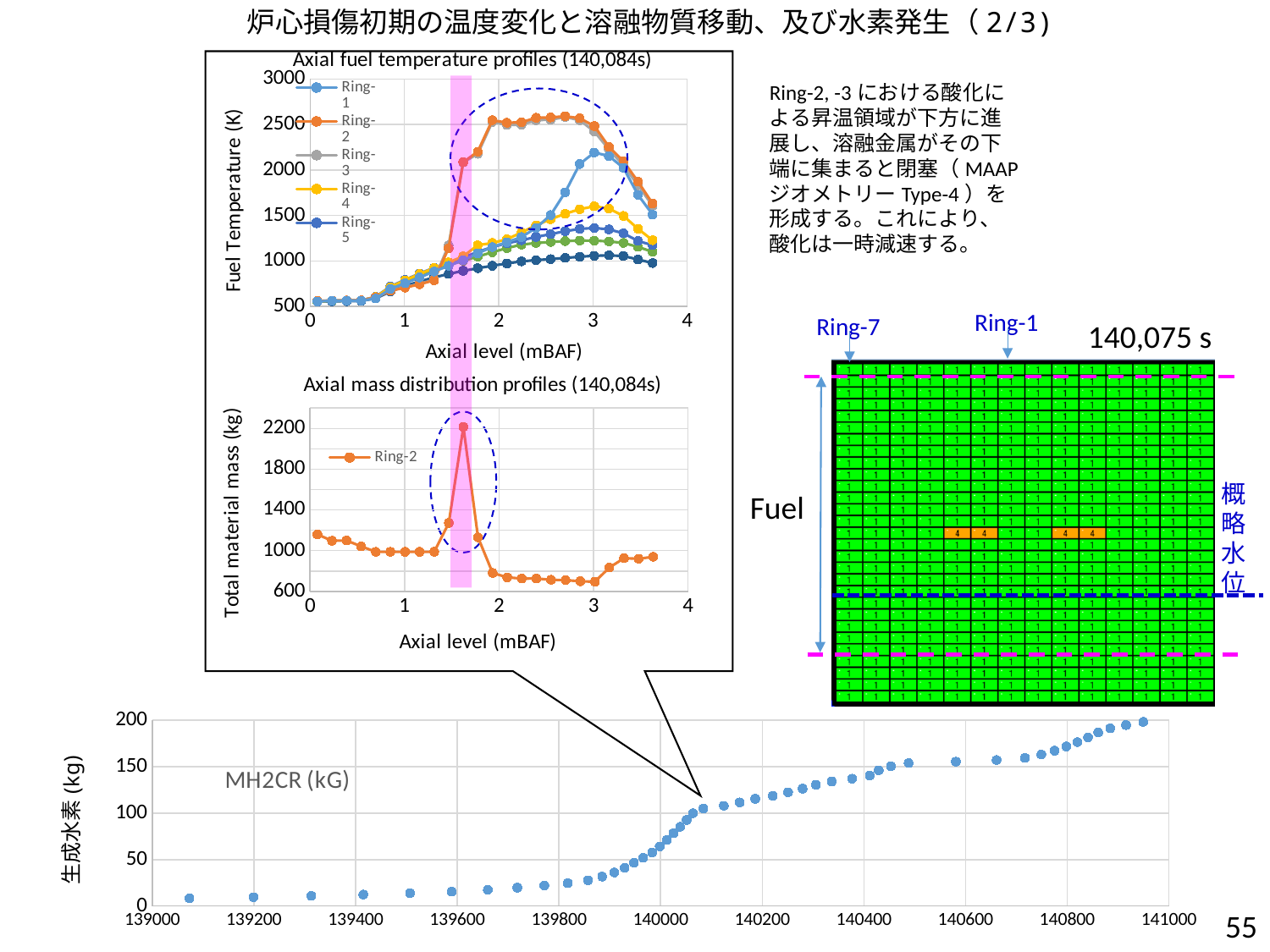
In the 'Axial fuel temperature profiles (140,084s)' chart, is the Ring-2 fuel temperature at an axial level of 2.5 mBAF greater or less than 2000 K? greater In the 'Axial mass distribution profiles (140,084s)' chart, is the peak total material mass of Ring-2 greater or less than 1800 kg? greater In the 'Axial fuel temperature profiles (140,084s)' chart, which series reaches the highest fuel temperature? Ring-2 In the bottom chart labelled 'MH2CR (kG)', is the generated hydrogen at about 139200 s greater or less than 50 kg? less In the 'Axial mass distribution profiles (140,084s)' chart, how many series does the legend list? 1 In the 'Axial fuel temperature profiles (140,084s)' chart, which series has the higher temperature at an axial level of 3 mBAF, Ring-1 or Ring-4? Ring-1 In the 'Axial fuel temperature profiles (140,084s)' chart, how many series does the legend list? 5 What kind of chart is the 'Axial mass distribution profiles (140,084s)' chart? Line chart In the bottom chart labelled 'MH2CR (kG)', do the values rise or fall as time increases along the x axis? rise